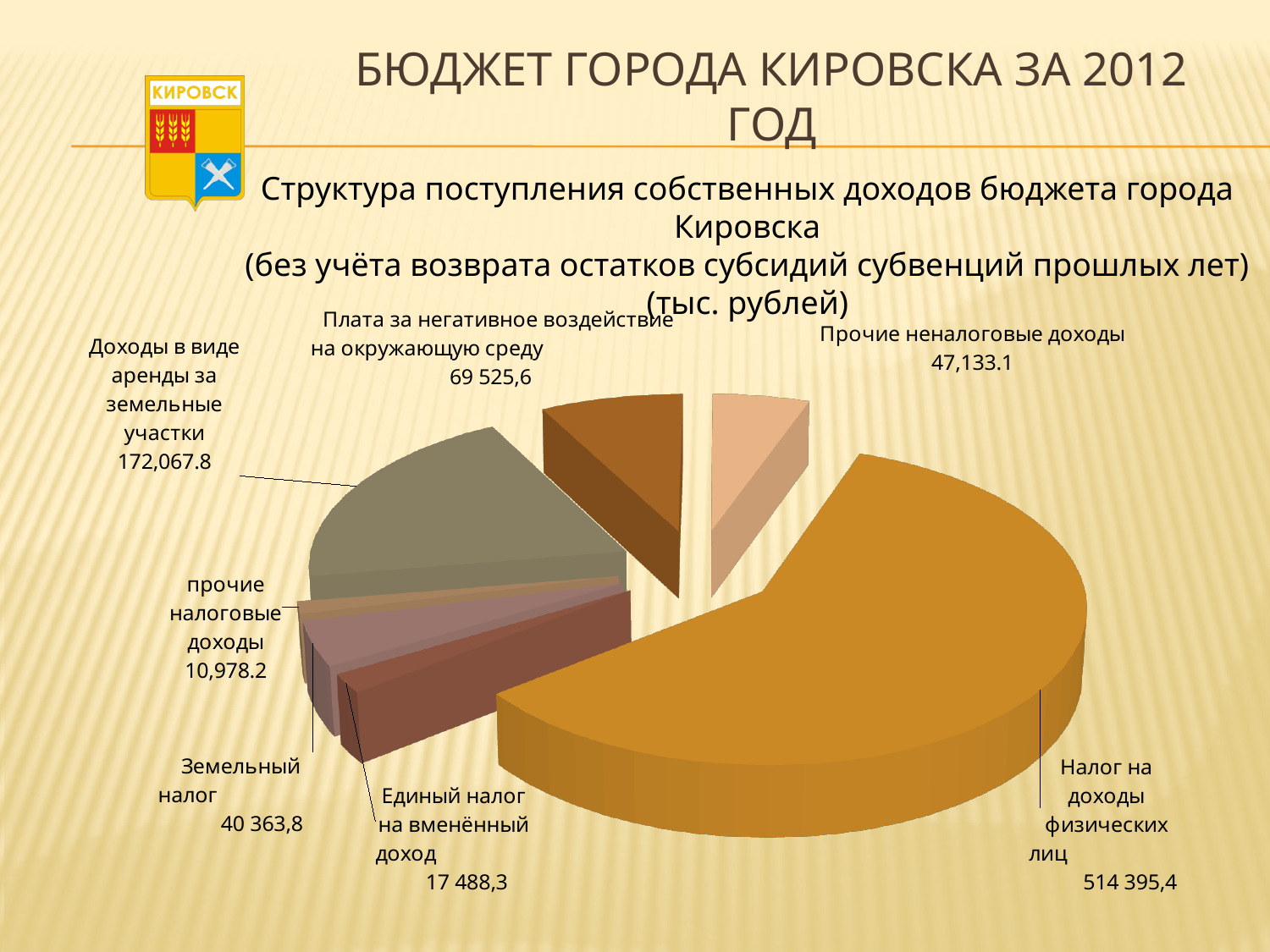
Which category has the largest slice of the pie? Налог на доходы физических лиц Which is larger: Земельный налог or Прочие неналоговые доходы? Прочие неналоговые доходы What is the value for Доходы в виде аренды за земельные участки? 172,067.8 What is the value for прочие налоговые доходы? 10,978.2 What is the value for Плата за негативное воздействие на окружающую среду? 69 525,6 In what units are the values on the chart given? тыс. рублей What is the difference between Земельный налог and Единый налог на вменённый доход? 22 875,5 How many slices does the pie chart have? 7 What is the value for Налог на доходы физических лиц? 514 395,4 What kind of chart is shown on the slide? pie chart Which category has the smallest slice of the pie? прочие налоговые доходы What is the value for Единый налог на вменённый доход? 17 488,3